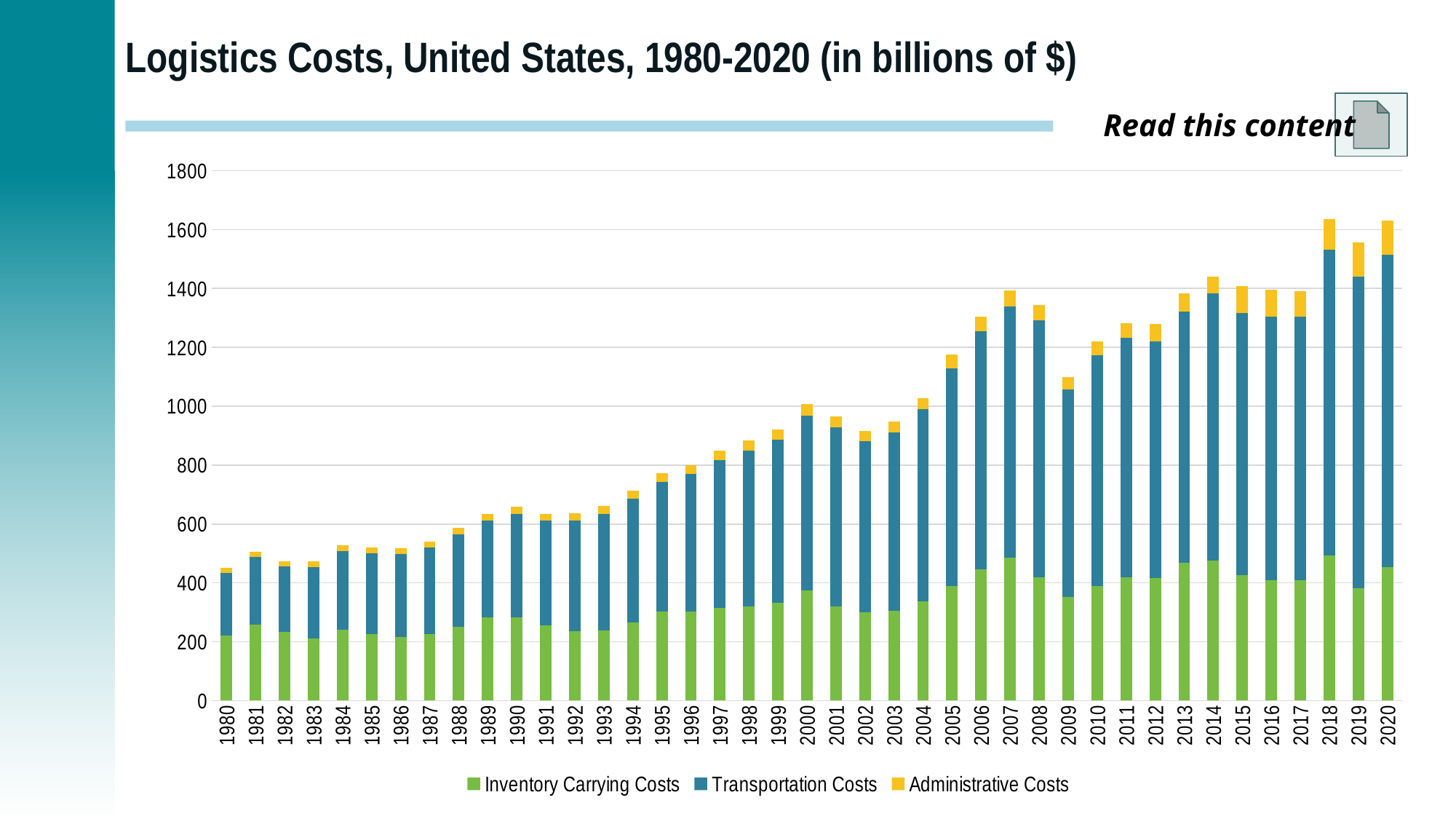
Which year has the lowest total logistics cost? 1980 Do total logistics costs generally rise or fall from 1980 to 2020? Rise Which year has the larger total logistics cost, 2008 or 2009? 2008 Is the total logistics cost for 2009 greater or less than 1000? greater Which year has the larger total logistics cost, 2018 or 2019? 2018 What is the title of the chart? Logistics Costs, United States, 1980-2020 (in billions of $) What kind of chart is shown on the slide? Stacked bar chart Is the total logistics cost for 1980 greater or less than 600? less How many years (bars) are plotted along the x axis? 41 Which series is shown in green? Inventory Carrying Costs How many series does the legend list? 3 Is the total logistics cost for 2007 greater or less than 1200? greater